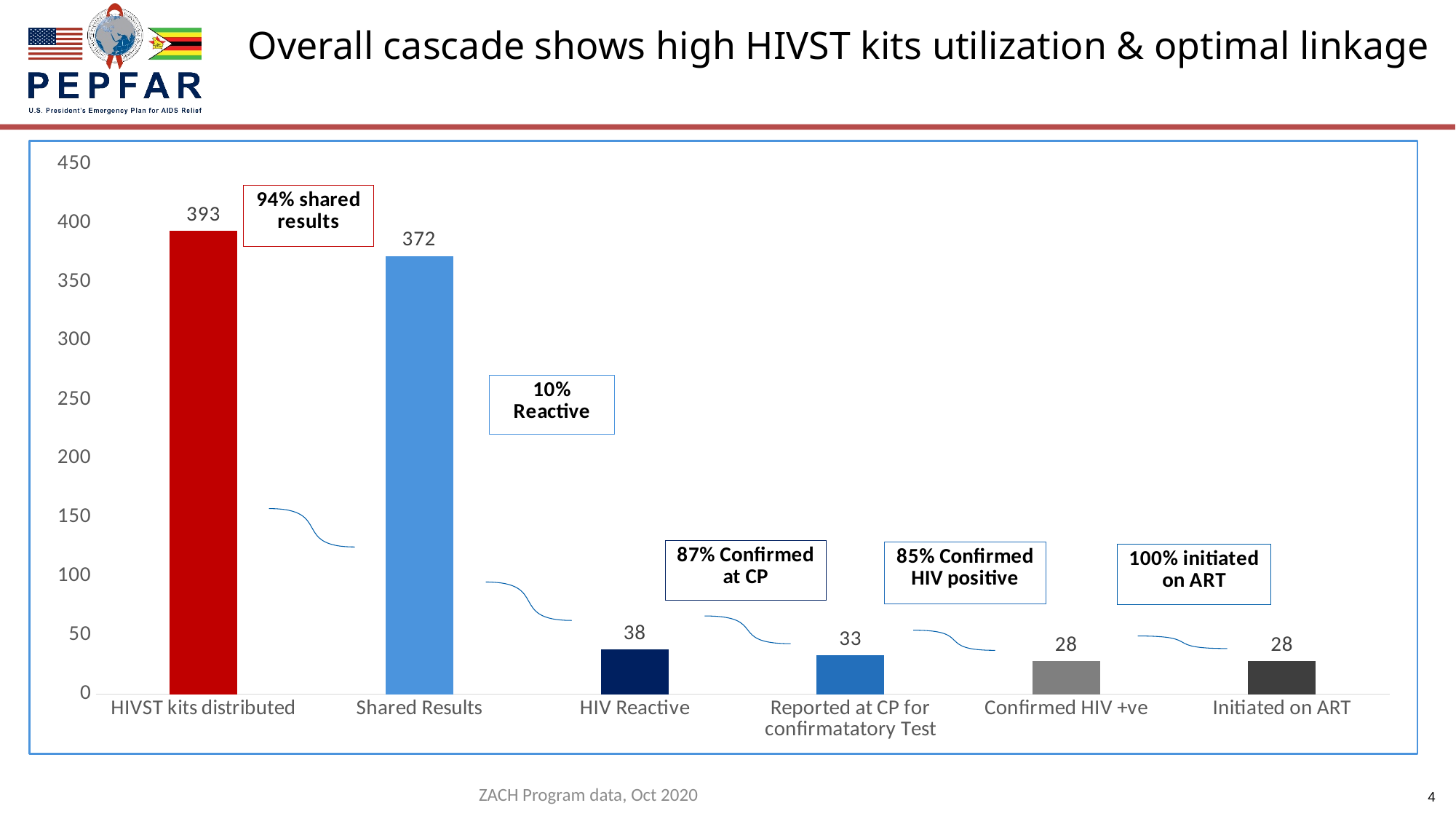
How many categories are shown on the x axis? 6 What is the value for HIVST kits distributed? 393 Is the value for Confirmed HIV +ve greater or less than 50? less What percentage is shown in the annotation box between HIVST kits distributed and Shared Results? 94% What kind of chart is shown on the slide? bar chart What is the difference between HIVST kits distributed and Shared Results? 21 What is the difference between HIV Reactive and Reported at CP for confirmatatory Test? 5 Which category has the highest value? HIVST kits distributed What is the value for Shared Results? 372 What is the value for HIV Reactive? 38 What is the value for Reported at CP for confirmatatory Test? 33 Which is larger, the value for Shared Results or the value for HIV Reactive? Shared Results